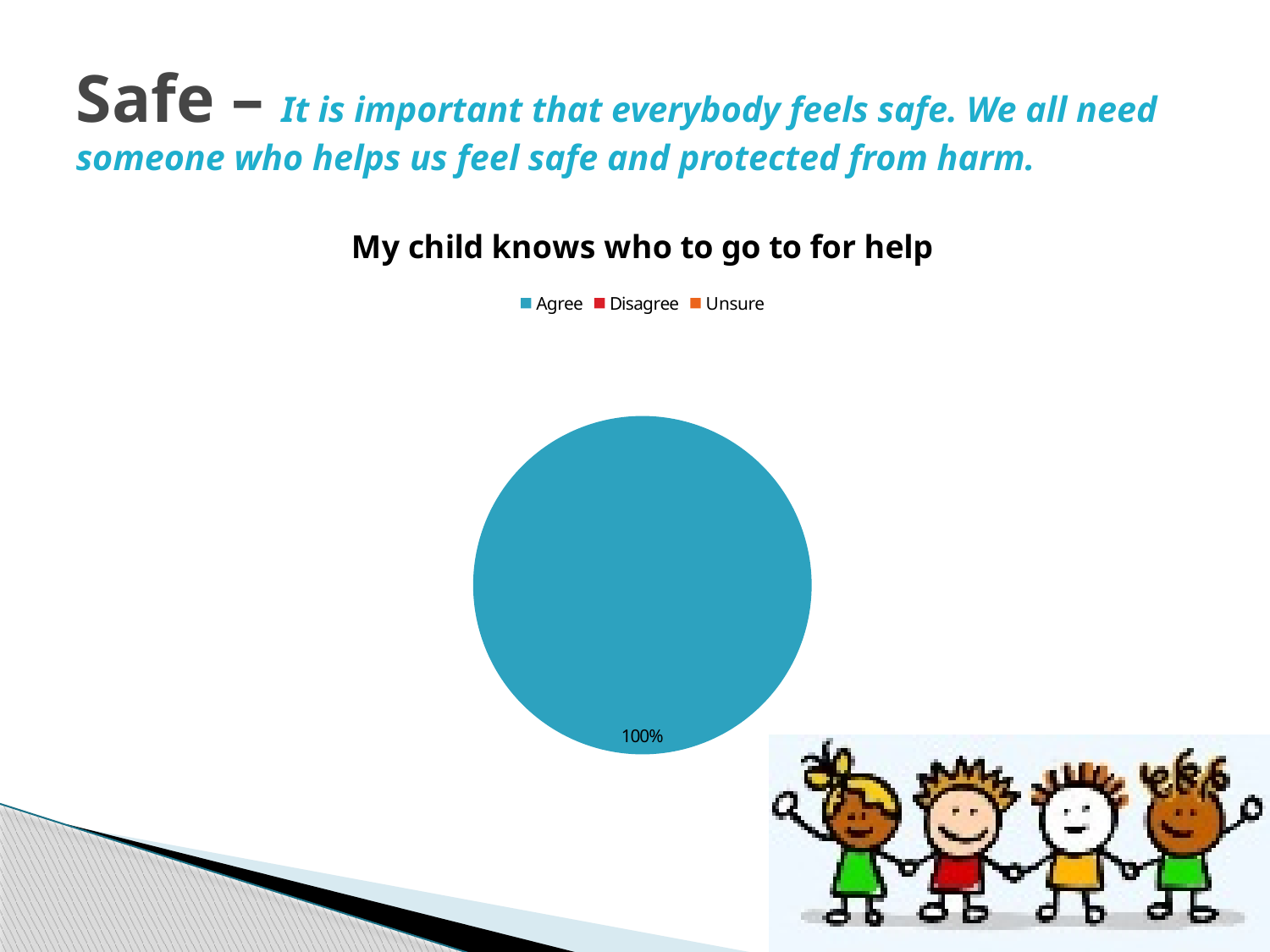
Is the share for Agree greater or less than 50%? greater How many entries does the chart's legend list? 3 Which category has the largest share of the pie? Agree Which is larger, the share for Agree or the share for Disagree? Agree Which legend entry is shown in blue? Agree What value is printed as the data label on the pie? 100% What kind of chart is shown on the slide? pie chart What share of the pie does the Agree slice take? 100% What is the title of the chart? My child knows who to go to for help